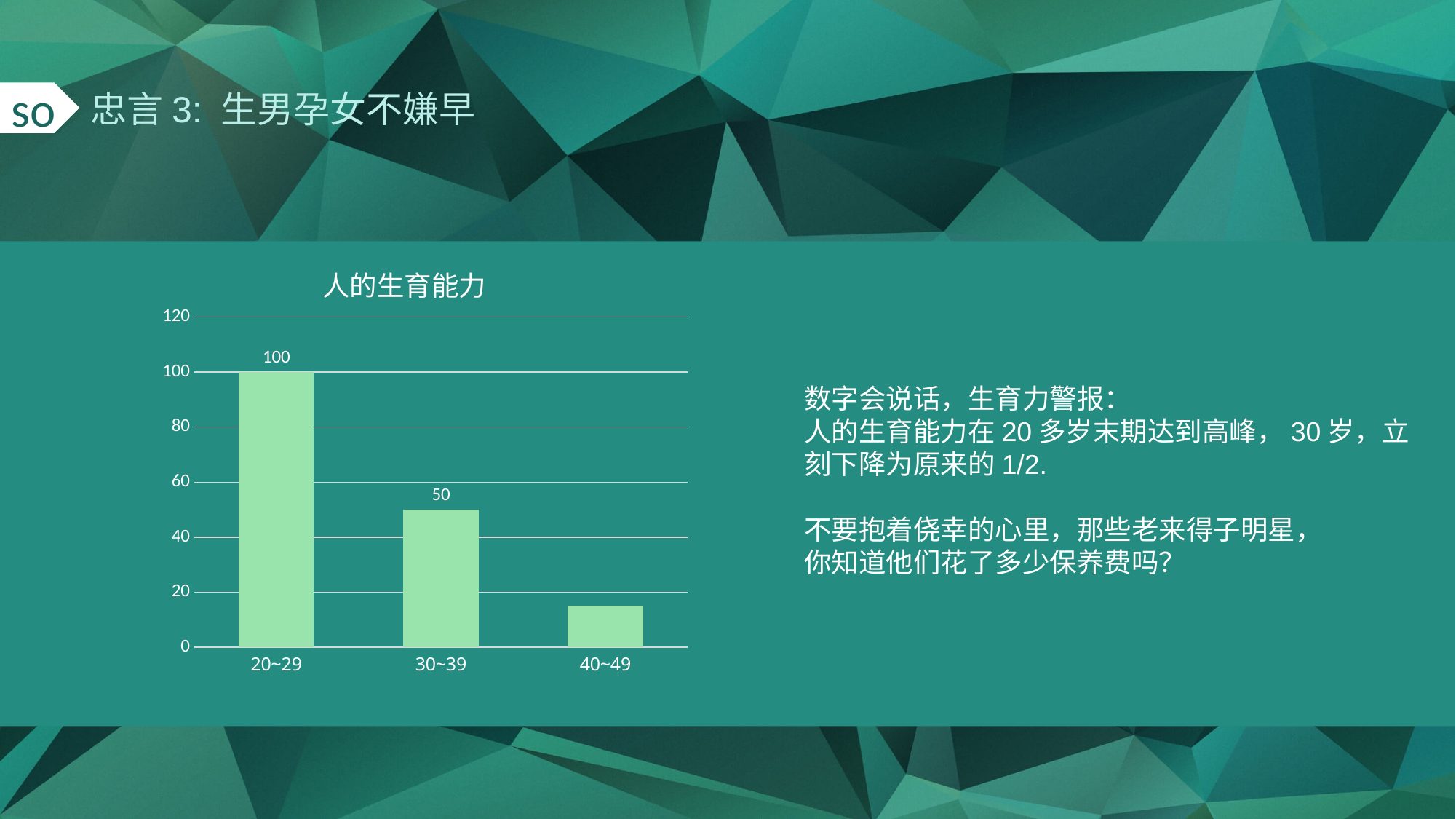
Do the values rise or fall as age increases along the x axis? fall Which age group has the highest value? 20~29 What is the value for the 20~29 age group? 100 What kind of chart is shown on the slide? bar chart What is the title of the chart? 人的生育能力 Is the value for 40~49 greater or less than 20? less What is the highest value shown on the y axis? 120 Which is larger, the value for 30~39 or the value for 40~49? 30~39 What is the difference between the values for 20~29 and 30~39? 50 How many age groups are shown on the x axis? 3 Which age group has the lowest value? 40~49 What is the value for the 30~39 age group? 50